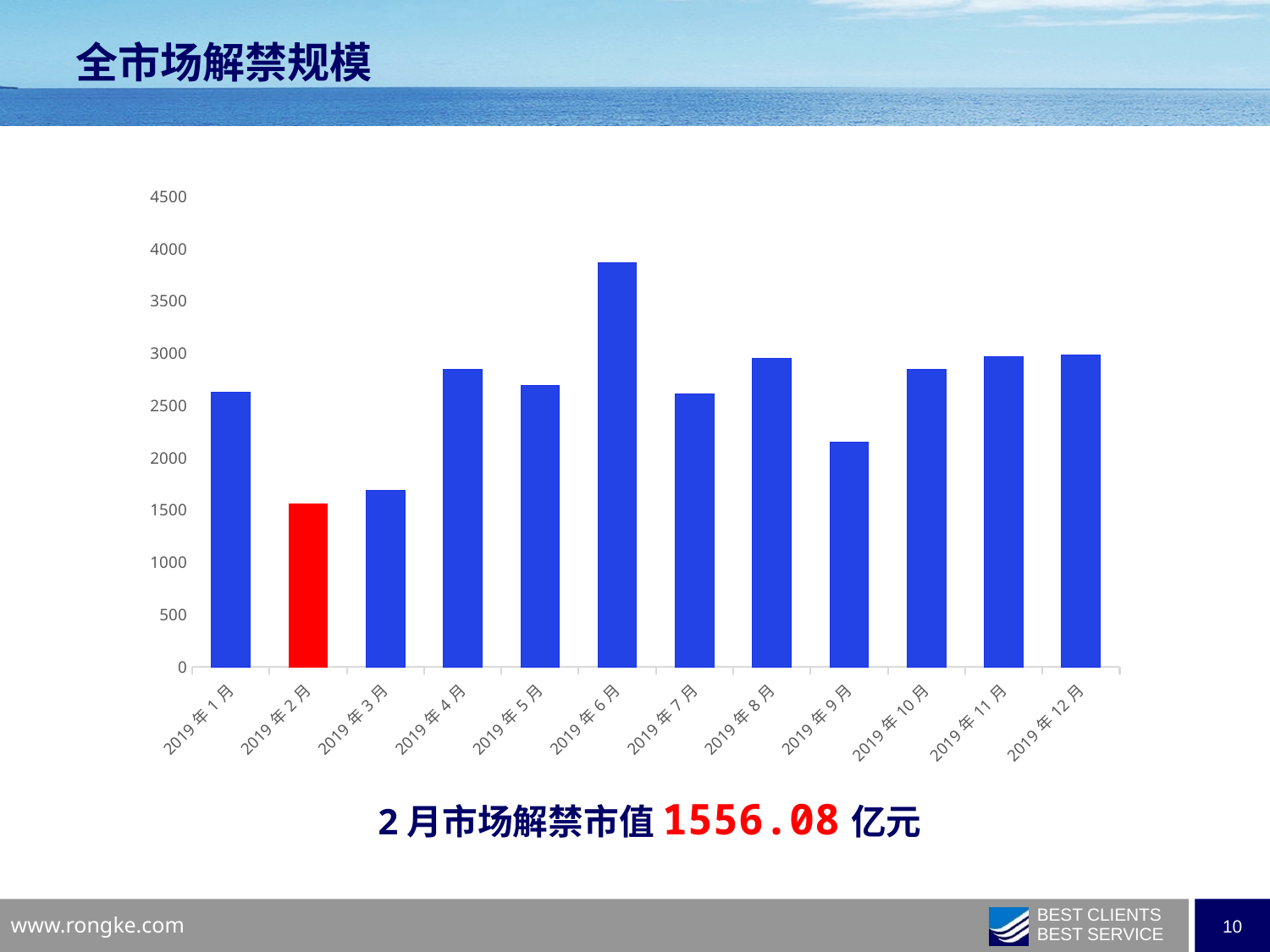
Is the value for 2019年4月 greater or less than 3000? less Is the value for 2019年6月 greater or less than 3500? greater Which bar is coloured red instead of blue? 2019年2月 What is the title of the slide containing the chart? 全市场解禁规模 Which month has the highest bar? 2019年6月 How many months (categories) are plotted on the x axis? 12 Which month has the lowest bar? 2019年2月 Is the value for 2019年3月 greater or less than 2000? less What kind of chart is shown on the slide? bar chart Which is larger, the value for 2019年1月 or 2019年9月? 2019年1月 What is the market unlock value (解禁市值) for 2019年2月 as stated on the slide? 1556.08 亿元